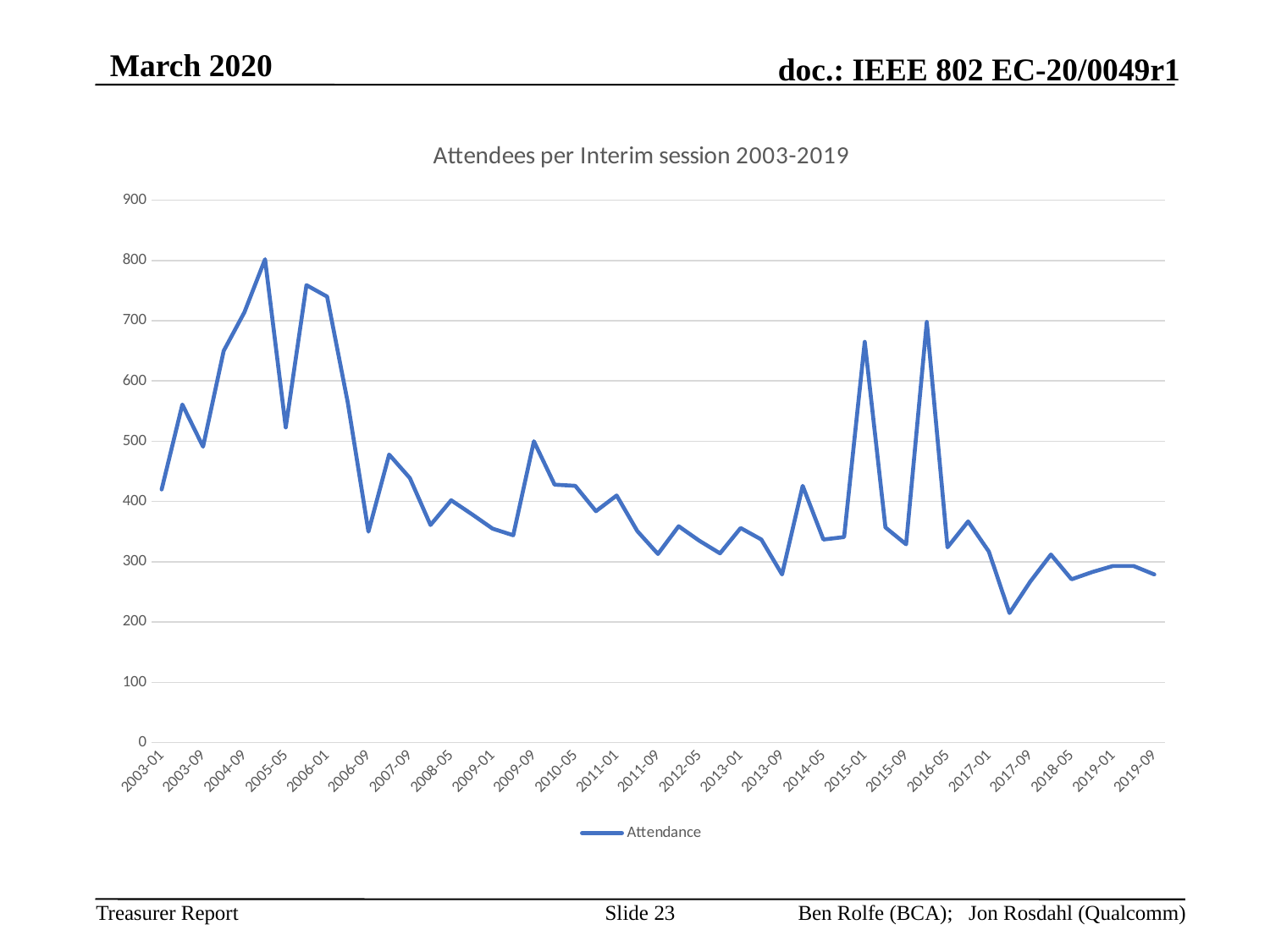
Does attendance rise or fall between 2006-01 and 2006-09? fall Is the attendance value for 2005-05 greater or less than 600? less What kind of chart is shown on the slide? line chart Which has the higher attendance, 2003-09 or 2019-09? 2003-09 How many series does the legend list? 1 Is the attendance value for 2015-01 greater or less than 600? greater What is the title of the chart? Attendees per Interim session 2003-2019 Is the attendance value for 2017-09 greater or less than 300? less What is the name of the series shown in the legend? Attendance